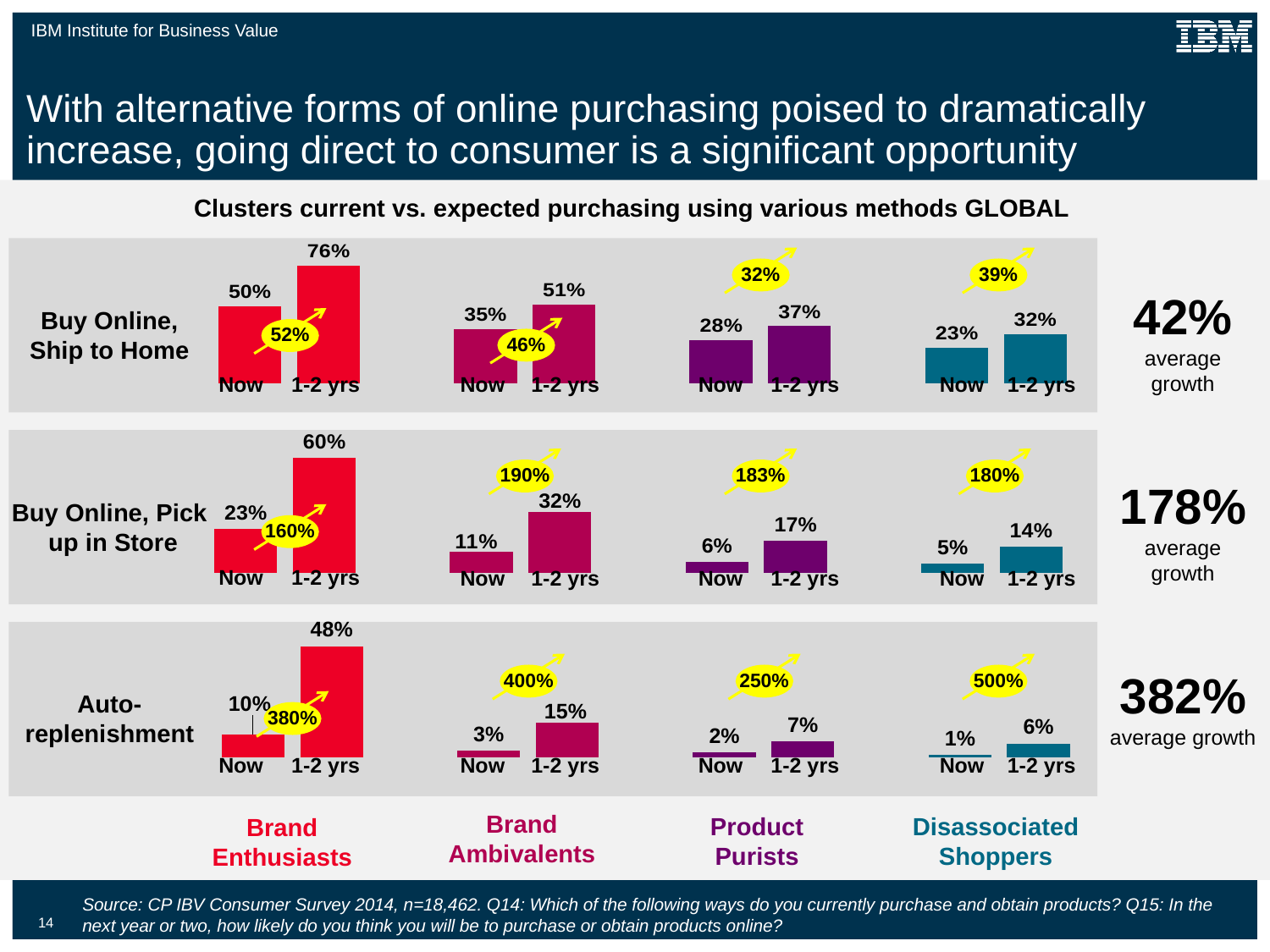
What kind of chart is used for each cluster in the grid? Bar chart In the Buy Online, Pick up in Store row, what is the Now value for Product Purists? 6% What is the average growth shown for the Auto-replenishment row? 382% In the Auto-replenishment row, which is larger for Brand Ambivalents: the Now value or the 1-2 yrs value? 1-2 yrs In the Buy Online, Ship to Home row, what is the 1-2 yrs value for Brand Enthusiasts? 76% In the Buy Online, Pick up in Store row, what is the difference between the 1-2 yrs and Now values for Brand Enthusiasts? 37% In the Auto-replenishment row, which cluster has the lowest Now value? Disassociated Shoppers In the Buy Online, Pick up in Store row, which cluster has the highest 1-2 yrs value? Brand Enthusiasts How many consumer clusters are shown across the bottom of the chart grid? 4 In the Auto-replenishment row, what is the 1-2 yrs value for Disassociated Shoppers? 6% In the Buy Online, Ship to Home row, what is the difference between the 1-2 yrs and Now values for Product Purists? 9% In the Buy Online, Ship to Home row, what growth percentage is shown in the yellow callout for Brand Ambivalents? 46%